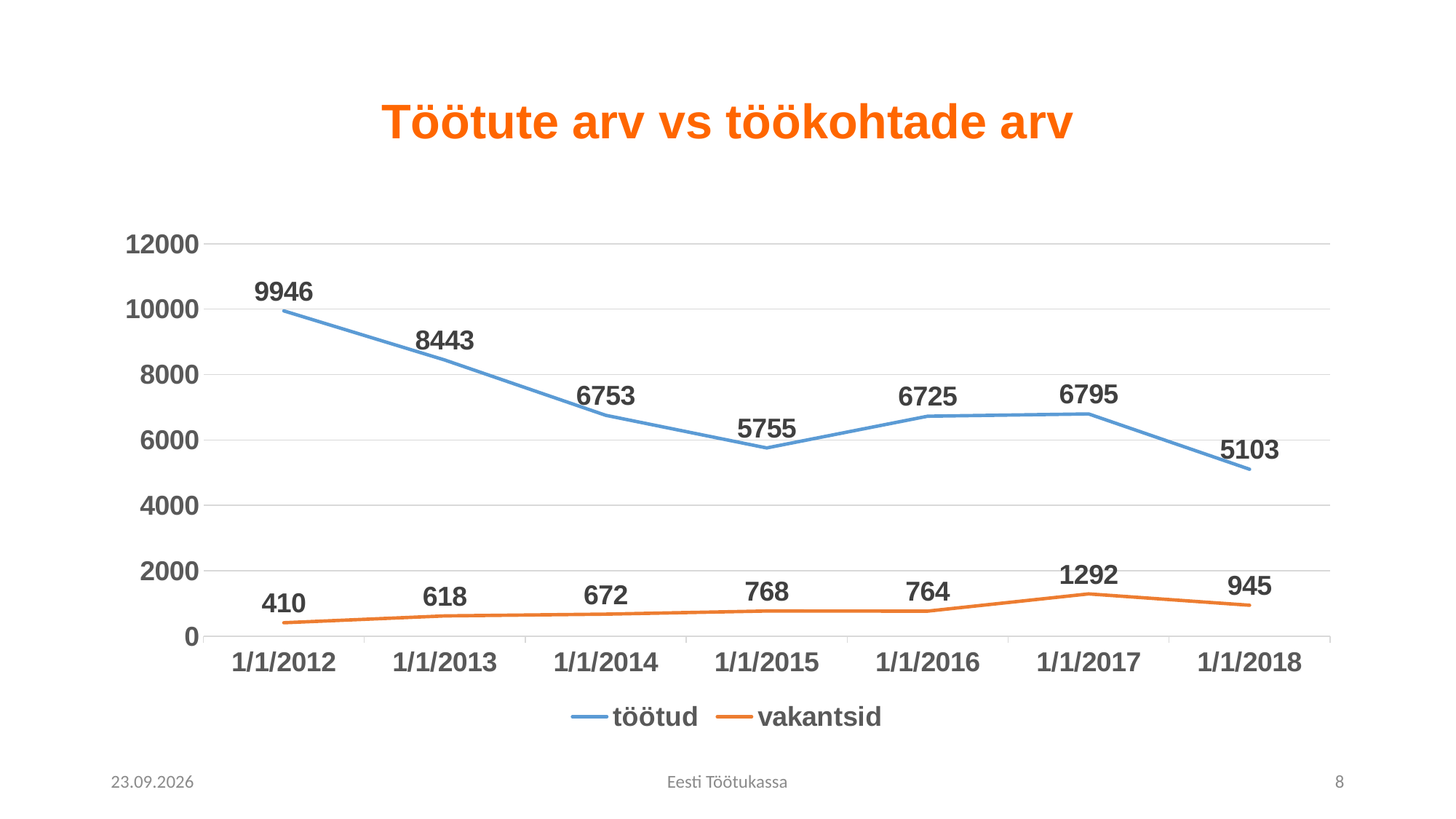
What is the value of töötud on 1/1/2012? 9946 What is the value of töötud on 1/1/2018? 5103 How many series does the legend list? 2 What is the title of the chart? Töötute arv vs töökohtade arv What kind of chart is shown on the slide? line chart What is the value of vakantsid on 1/1/2017? 1292 What is the difference between töötud and vakantsid on 1/1/2015? 4987 Which is larger, the vakantsid value on 1/1/2016 or on 1/1/2018? 1/1/2018 How many dates are shown on the x axis? 7 What is the difference between the töötud values on 1/1/2012 and 1/1/2013? 1503 On which date is the töötud value lowest? 1/1/2018 On which date is the vakantsid value highest? 1/1/2017